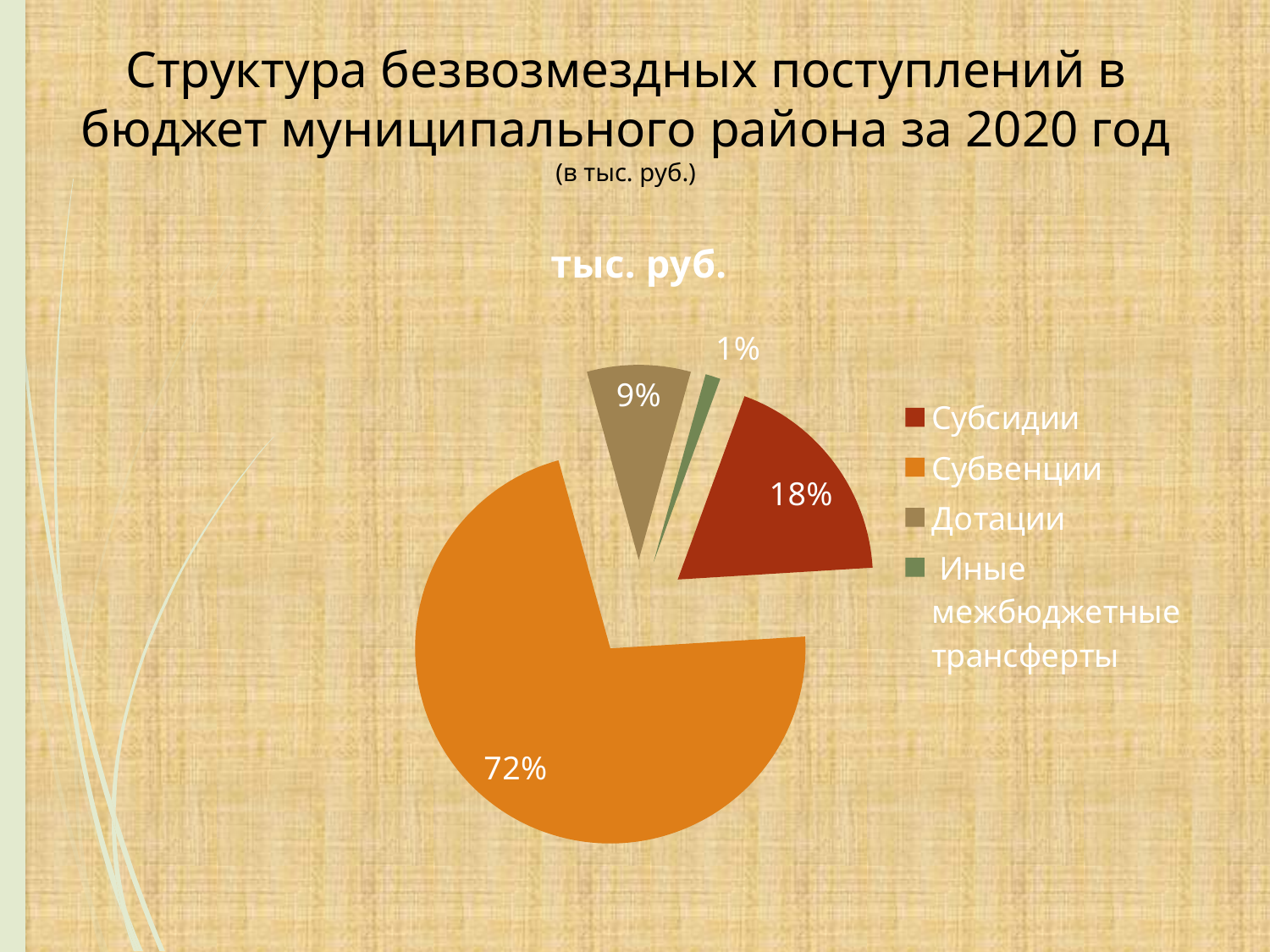
Which category has the smallest slice of the pie? Иные межбюджетные трансферты What is the title shown above the pie chart? тыс. руб. What share of the pie does Иные межбюджетные трансферты hold? 1% What is the difference in percentage points between the Субвенции and Субсидии slices? 54 How many categories does the pie chart show? 4 What share of the pie does Субсидии hold? 18% What share of the pie does Дотации hold? 9% What kind of chart is shown on the slide? Pie chart What colour is the Дотации slice in the legend? Tan/brown Which category has the largest slice of the pie? Субвенции Which slice is larger, Субсидии or Дотации? Субсидии